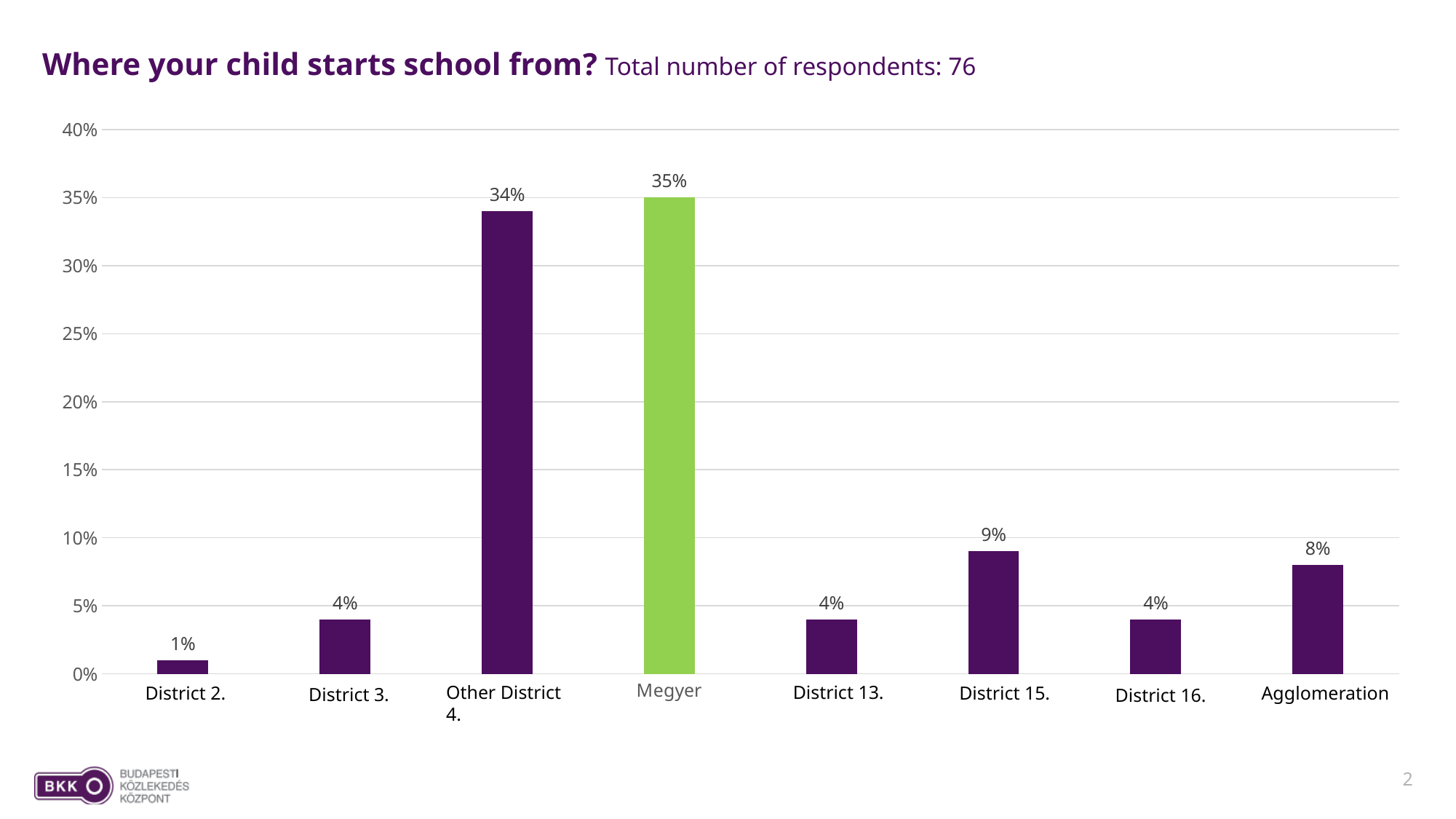
What is the value shown for Other District 4.? 34% What is the difference between the values for District 15. and Agglomeration? 1% Which category has the highest value? Megyer What is the difference between the values for Other District 4. and District 3.? 30% How many categories are shown on the x axis? 8 Which bar is coloured green instead of purple? Megyer What is the value for District 2.? 1% Which category has the lowest value? District 2. What percentage is shown for Agglomeration? 8% What kind of chart is shown on the slide? Bar chart Which is larger, the value for District 15. or the value for District 16.? District 15. What percentage of respondents' children start school from Megyer? 35%